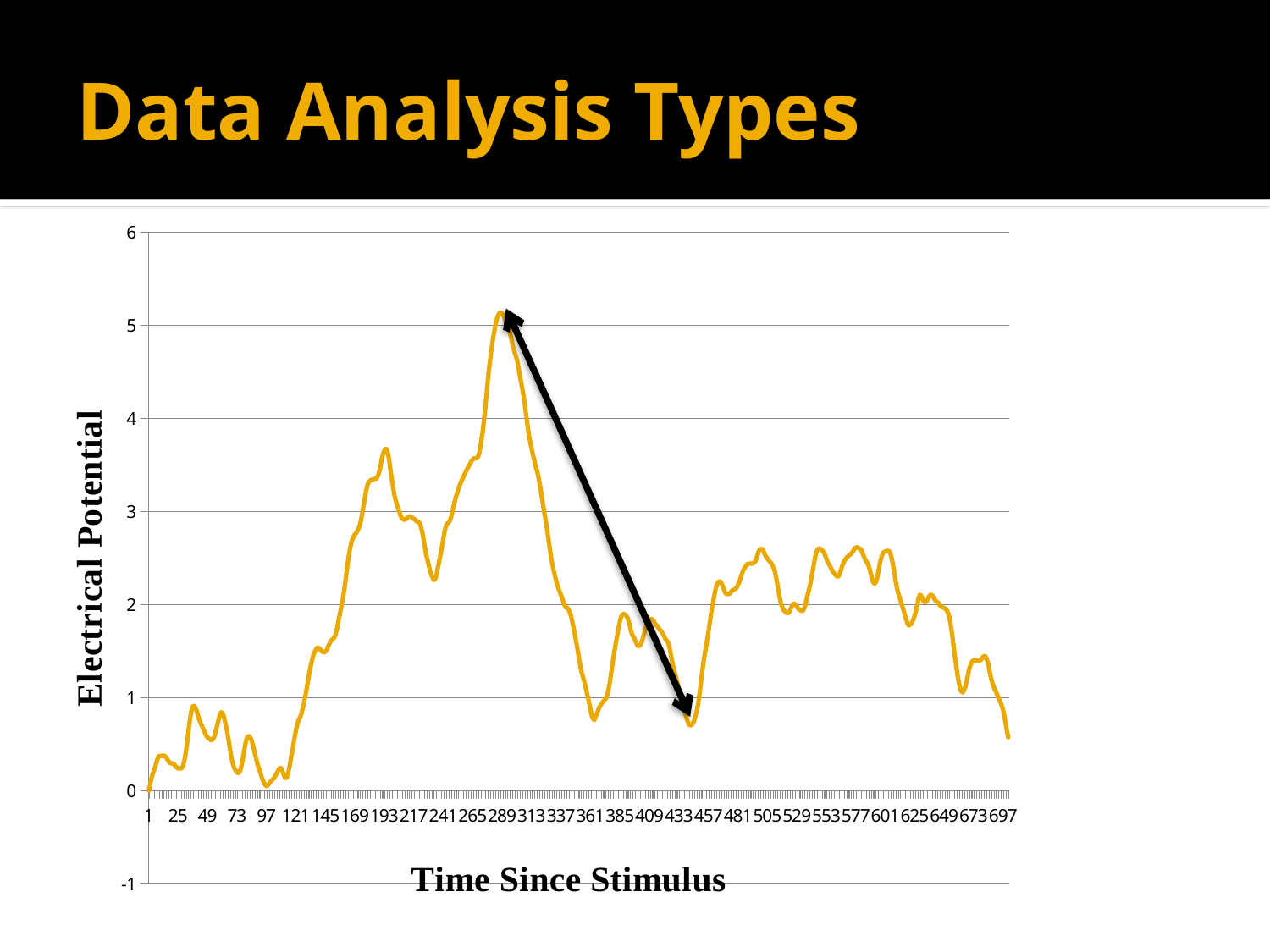
What is the title of the y axis of the chart? Electrical Potential Is the value of Electrical Potential at time 241 greater or less than 3? less Is the value of Electrical Potential at time 1 greater or less than 1? less What is the highest value shown on the y axis of the chart? 6 Does the Electrical Potential generally rise or fall between time 121 and time 289? rise Is the value of Electrical Potential at time 193 greater or less than 3? greater Does the Electrical Potential rise or fall between time 289 and time 433? fall What kind of chart is shown on the slide? line chart What is the title of the x axis of the chart? Time Since Stimulus